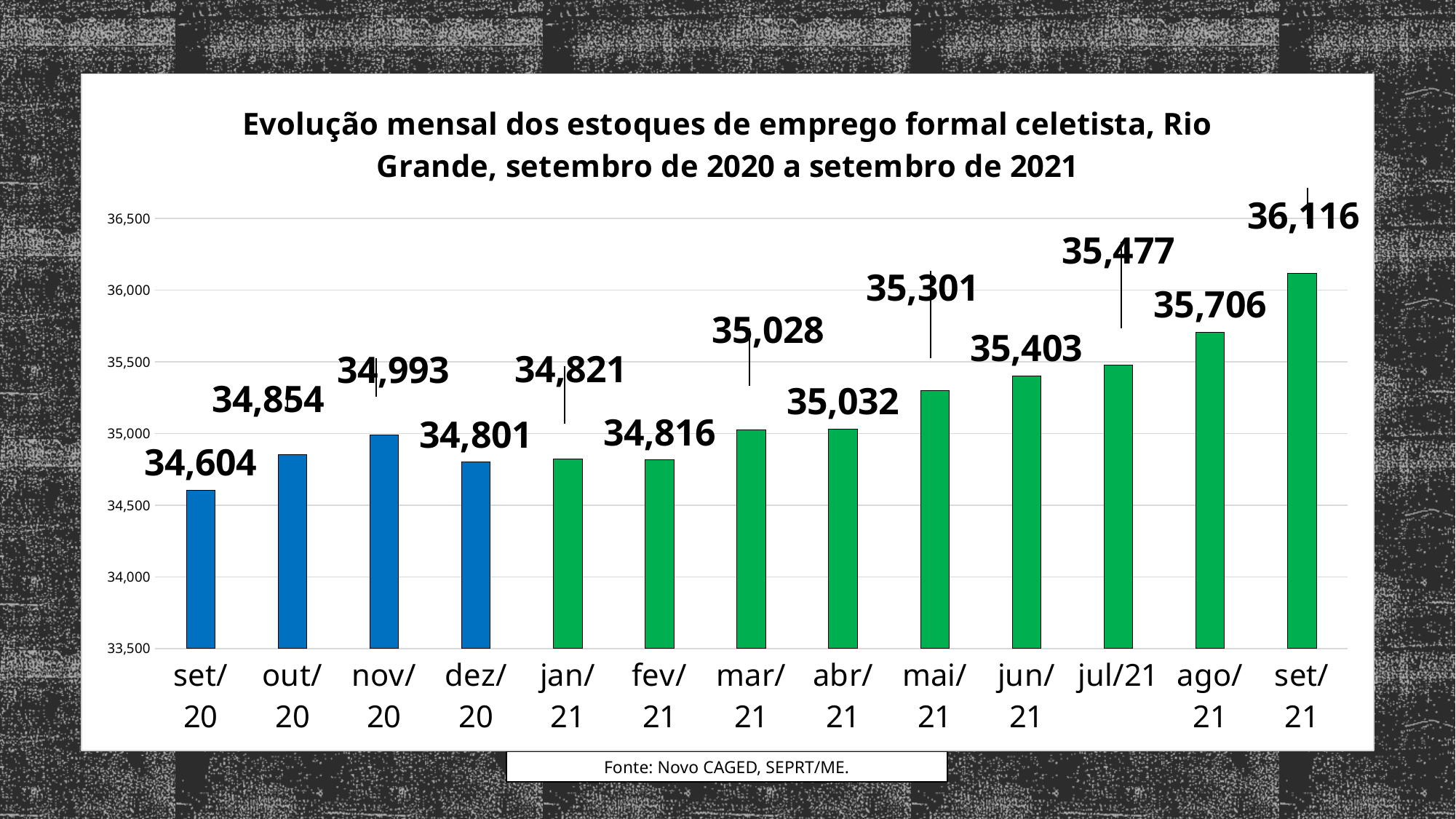
Which month has the highest value? set/21 How many months are shown on the x axis? 13 Is the value for jul/21 greater or less than 35,000? greater What kind of chart is shown on the slide? bar chart What is the difference between the values for nov/20 and dez/20? 192 Which is larger, the value for nov/20 or the value for jan/21? nov/20 What is the value for set/20? 34,604 What is the difference between the values for set/21 and set/20? 1,512 Which month has the lowest value? set/20 What is the value for mai/21? 35,301 How many bars are coloured blue? 4 What is the value for ago/21? 35,706